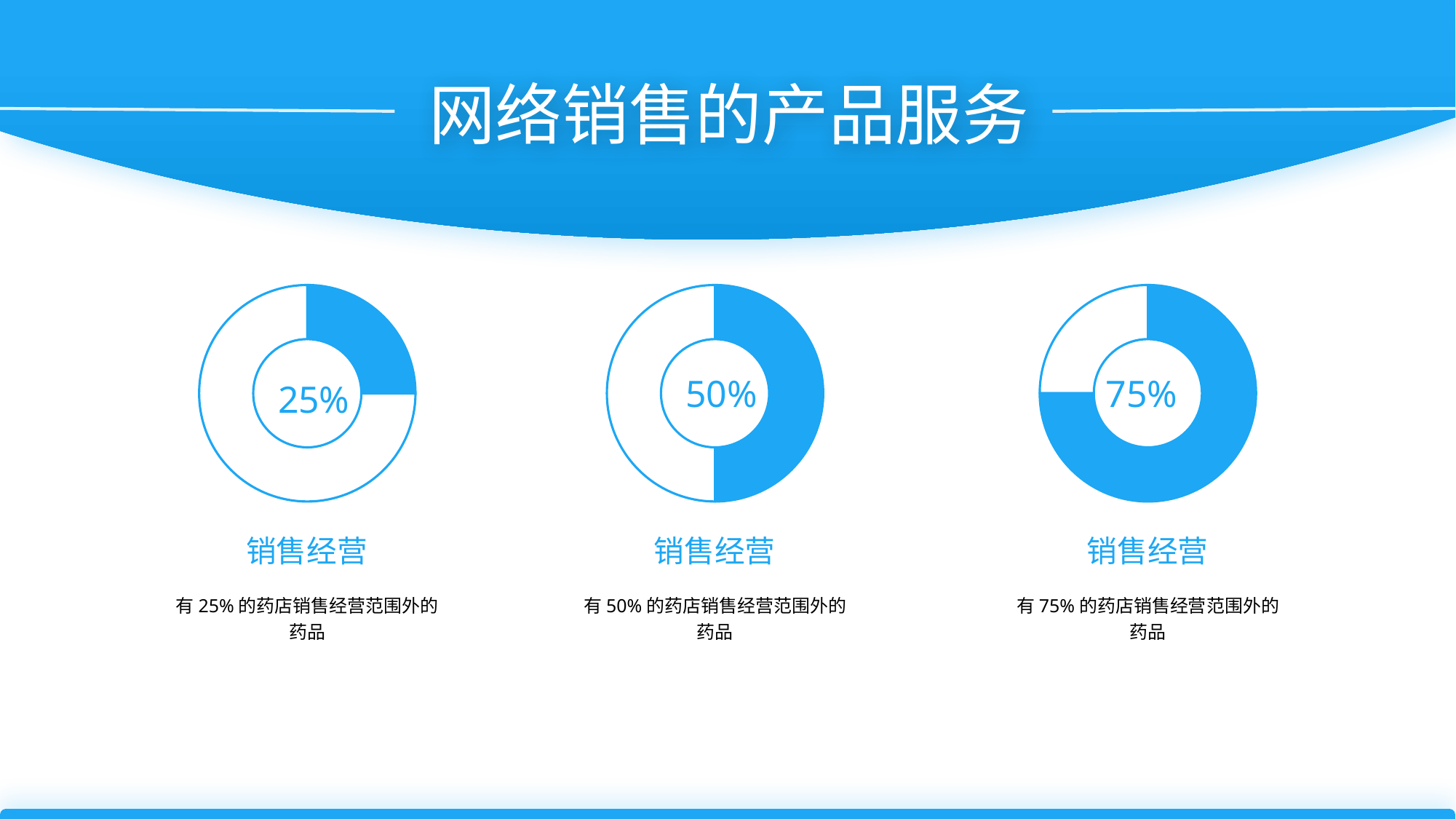
Which of the three donut charts shows the lowest percentage? The left chart (25%) How many donut charts are shown on the slide? 3 What is the label shown beneath each of the three donut charts? 销售经营 Which is larger, the percentage in the middle donut chart or the percentage in the left donut chart? The middle chart (50%) What is the difference between the percentage in the right donut chart and the percentage in the left donut chart? 50% What is the title of the slide containing the three donut charts? 网络销售的产品服务 What value is shown in the centre of the right donut chart? 75% Which of the three donut charts shows the highest percentage? The right chart (75%) What value is shown in the centre of the middle donut chart? 50% What kind of chart is used to display the percentages on this slide? Donut chart What value is shown in the centre of the left donut chart? 25% What is the difference between the percentage in the middle donut chart and the percentage in the left donut chart? 25%